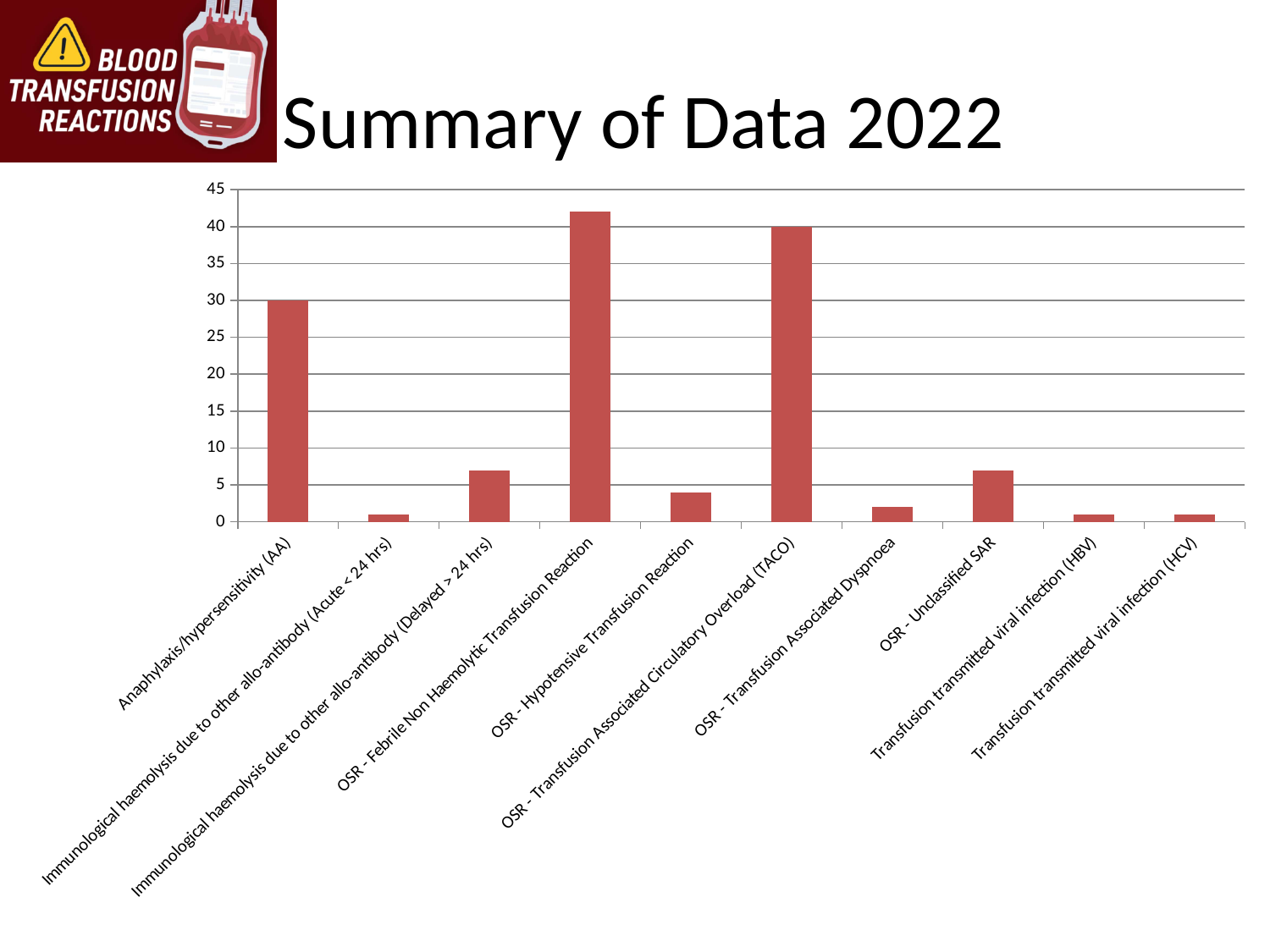
Is the value for OSR - Unclassified SAR greater or less than 5? greater What is the value for OSR - Transfusion Associated Circulatory Overload (TACO)? 40 What is the value for Anaphylaxis/hypersensitivity (AA)? 30 Is the value for OSR - Hypotensive Transfusion Reaction greater or less than 5? less How many categories are plotted on the x axis of the chart? 10 What is the title of the slide containing the chart? Summary of Data 2022 Which category has the highest value in the chart? OSR - Febrile Non Haemolytic Transfusion Reaction What type of chart is shown on the slide? Bar chart What colour are the bars in the chart? Red Is the value for Immunological haemolysis due to other allo-antibody (Delayed > 24 hrs) greater or less than 10? less Which is larger: the value for Anaphylaxis/hypersensitivity (AA) or the value for OSR - Transfusion Associated Dyspnoea? Anaphylaxis/hypersensitivity (AA)